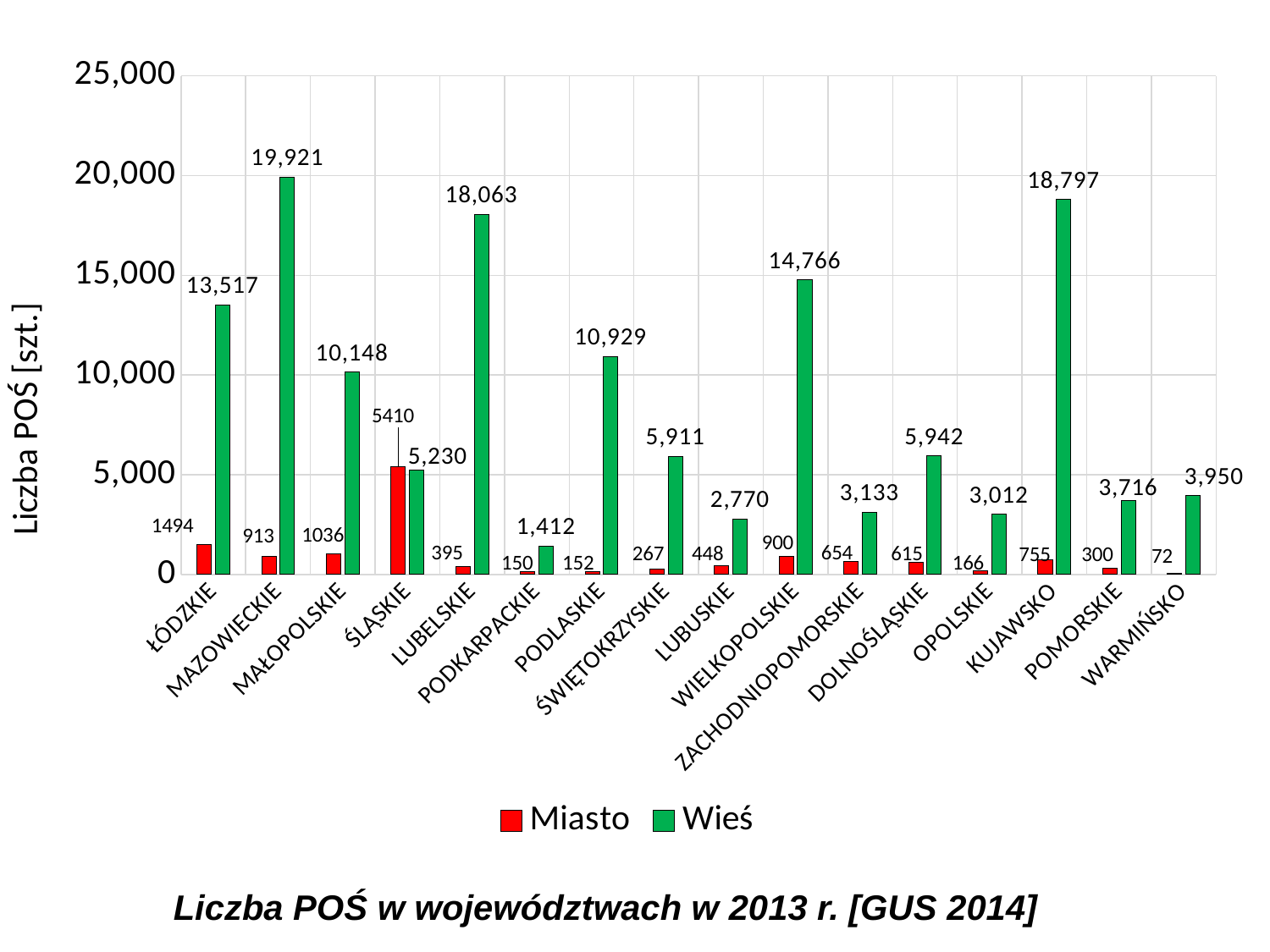
Which voivodeship has the lowest Wieś value? PODKARPACKIE Which voivodeship has the highest Wieś value? MAZOWIECKIE What is the combined Miasto and Wieś value for ŁÓDZKIE? 15,011 Which voivodeship has the lowest Miasto value? WARMIŃSKO What kind of chart is shown on the slide? bar chart What is the Miasto value for ŚLĄSKIE? 5410 How many series does the legend list? 2 What is the Wieś value for MAZOWIECKIE? 19,921 How much larger is the Miasto value than the Wieś value for ŚLĄSKIE? 180 How many voivodeships are shown on the x axis? 16 Is the Wieś value for PODLASKIE greater or less than 10,000? greater Which has the larger Wieś value, LUBELSKIE or KUJAWSKO? KUJAWSKO